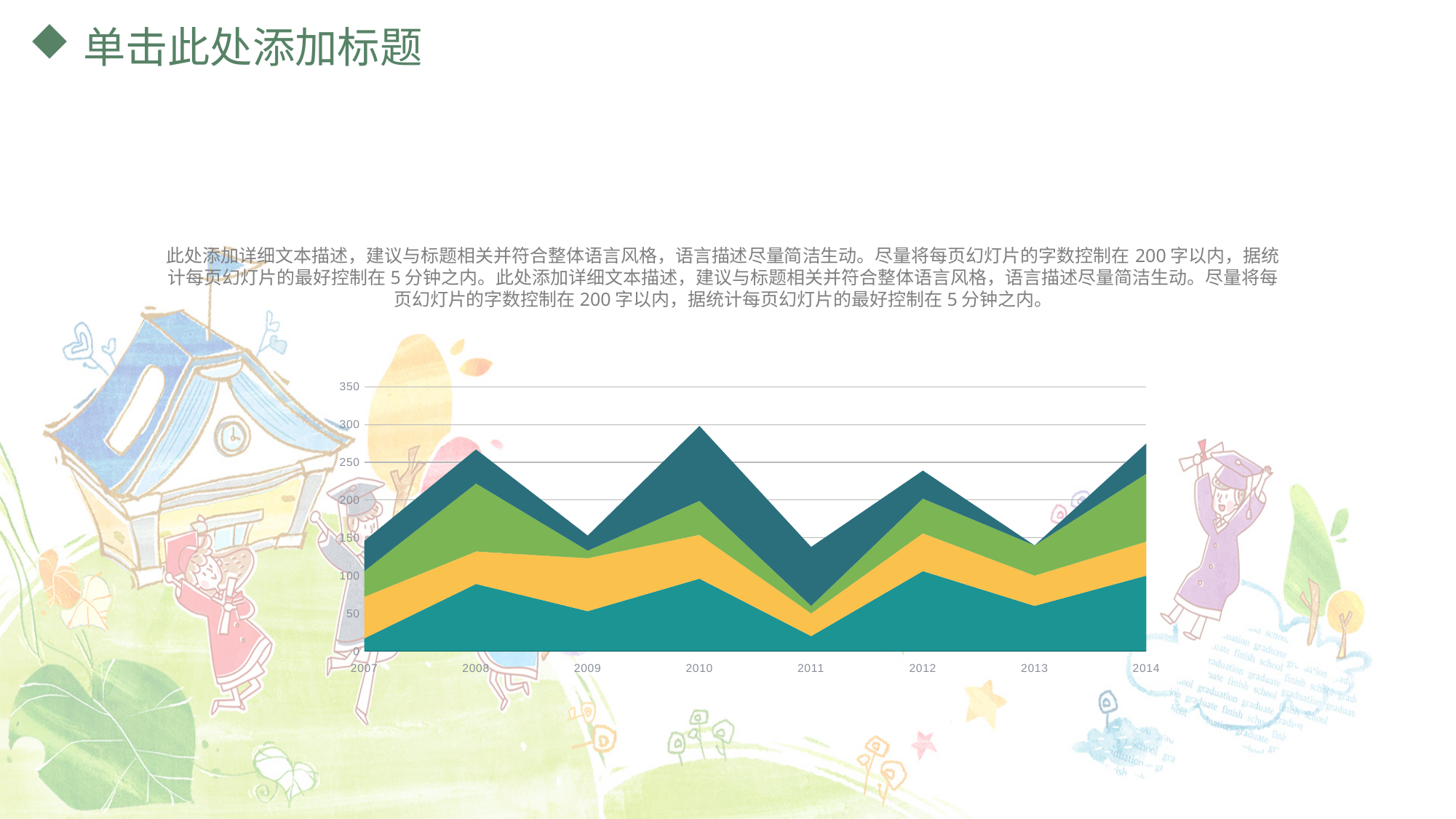
Is the value of the bottom (teal) series for 2011 greater or less than 50? less Which year has the larger stacked total, 2010 or 2011? 2010 Which year has the highest stacked total in the chart? 2010 Is the stacked total for 2009 greater or less than 200? less Does the stacked total rise or fall from 2013 to 2014? rise What is the highest value shown on the chart's y axis? 350 How many years are shown along the x axis of the chart? 8 Is the stacked total for 2011 greater or less than 200? less How many stacked series (colored layers) does the chart show? 4 What kind of chart is shown on the slide? Stacked area chart